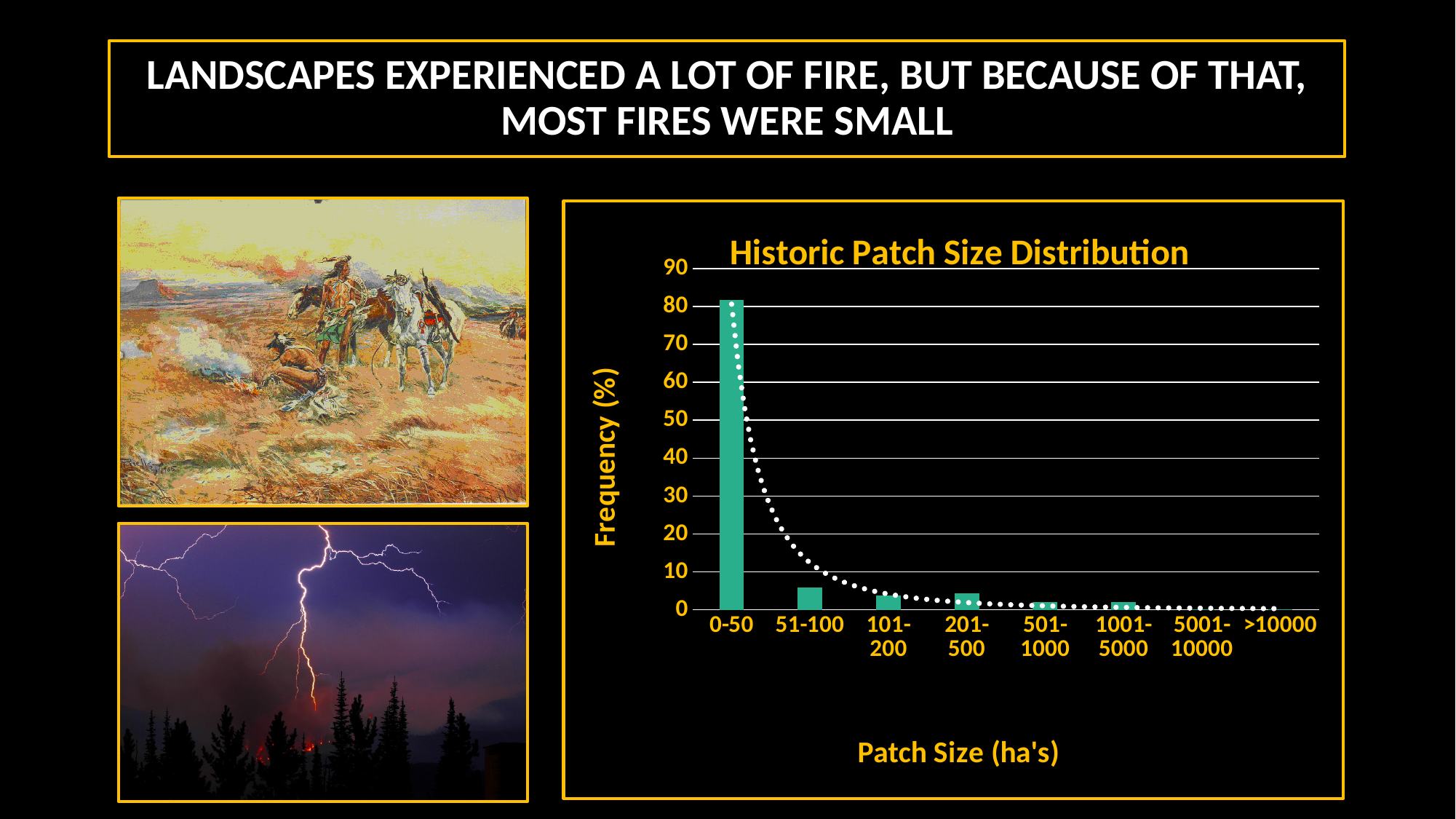
Do the frequencies generally rise or fall as patch size increases along the x axis? fall Which has a higher frequency, the 51-100 category or the 101-200 category? 51-100 What is the label of the y axis of the chart? Frequency (%) Is the frequency for the 51-100 patch size category greater or less than 10? less Is the frequency for the 201-500 patch size category greater or less than 10? less What kind of chart is the Historic Patch Size Distribution chart? bar chart Is the frequency for the 1001-5000 patch size category greater or less than 10? less How many patch size categories are shown on the x axis? 8 Which has a higher frequency, the 0-50 category or the 51-100 category? 0-50 Which patch size category has the highest frequency? 0-50 What is the title of the chart? Historic Patch Size Distribution